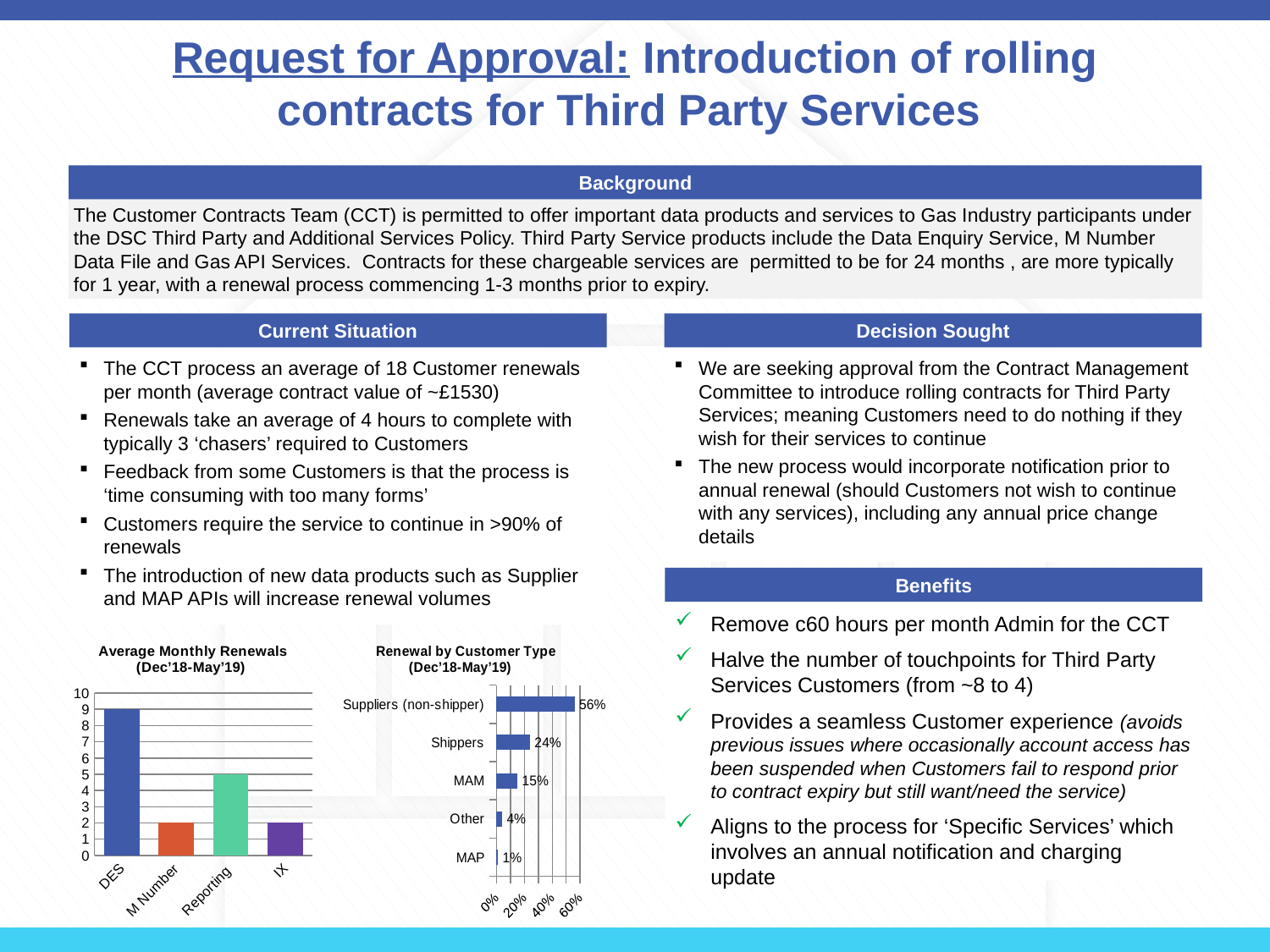
In the Average Monthly Renewals chart, is the value for DES greater or less than 8? greater In the Average Monthly Renewals chart, which category has the highest value? DES In the Average Monthly Renewals chart, is the value for Reporting greater or less than 4? greater In the Renewal by Customer Type chart, what is the value for Suppliers (non-shipper)? 56% In the Renewal by Customer Type chart, what is the value for MAM? 15% In the Renewal by Customer Type chart, what is the difference between the values for Shippers and MAM? 9% In the Renewal by Customer Type chart, which customer type has the highest value? Suppliers (non-shipper) In the Renewal by Customer Type chart, what is the value for Shippers? 24% What kind of chart is the Average Monthly Renewals chart? Bar chart In the Renewal by Customer Type chart, which customer type has the lowest value? MAP In the Renewal by Customer Type chart, how many customer types are shown? 5 In the Average Monthly Renewals chart, how many categories are shown on the x axis? 4